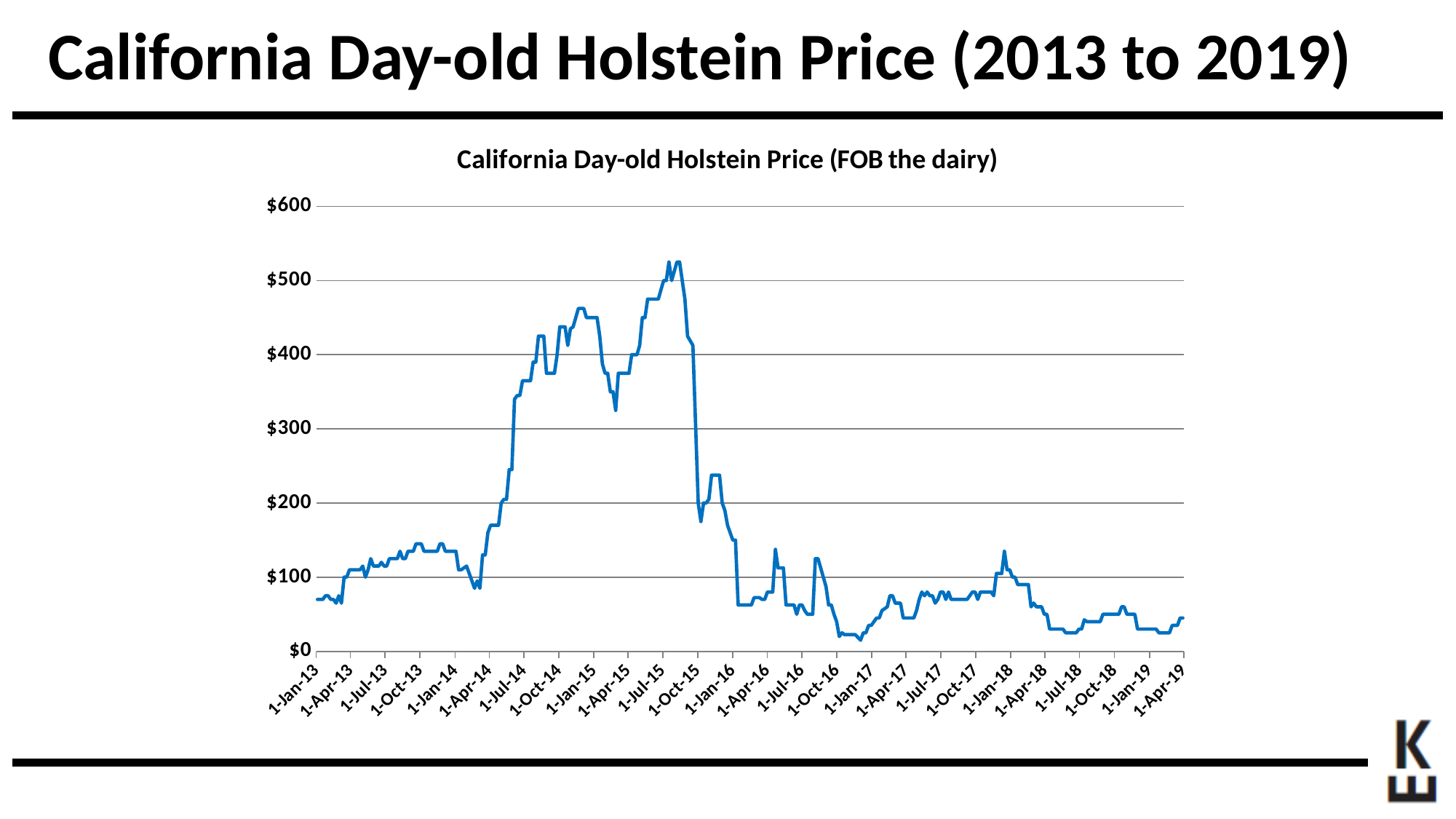
How many date labels are shown on the x axis? 26 What is the highest value shown on the y axis? $600 What kind of chart is shown on the slide? line chart Is the value for 1-Jan-17 greater or less than $100? less What is the title of the chart? California Day-old Holstein Price (FOB the dairy) Which is larger, the value for 1-Jul-15 or the value for 1-Jul-17? 1-Jul-15 Is the value for 1-Jul-15 greater or less than $400? greater Does the price rise or fall between 1-Oct-15 and 1-Jan-17? fall Is the value for 1-Jan-13 greater or less than $100? less